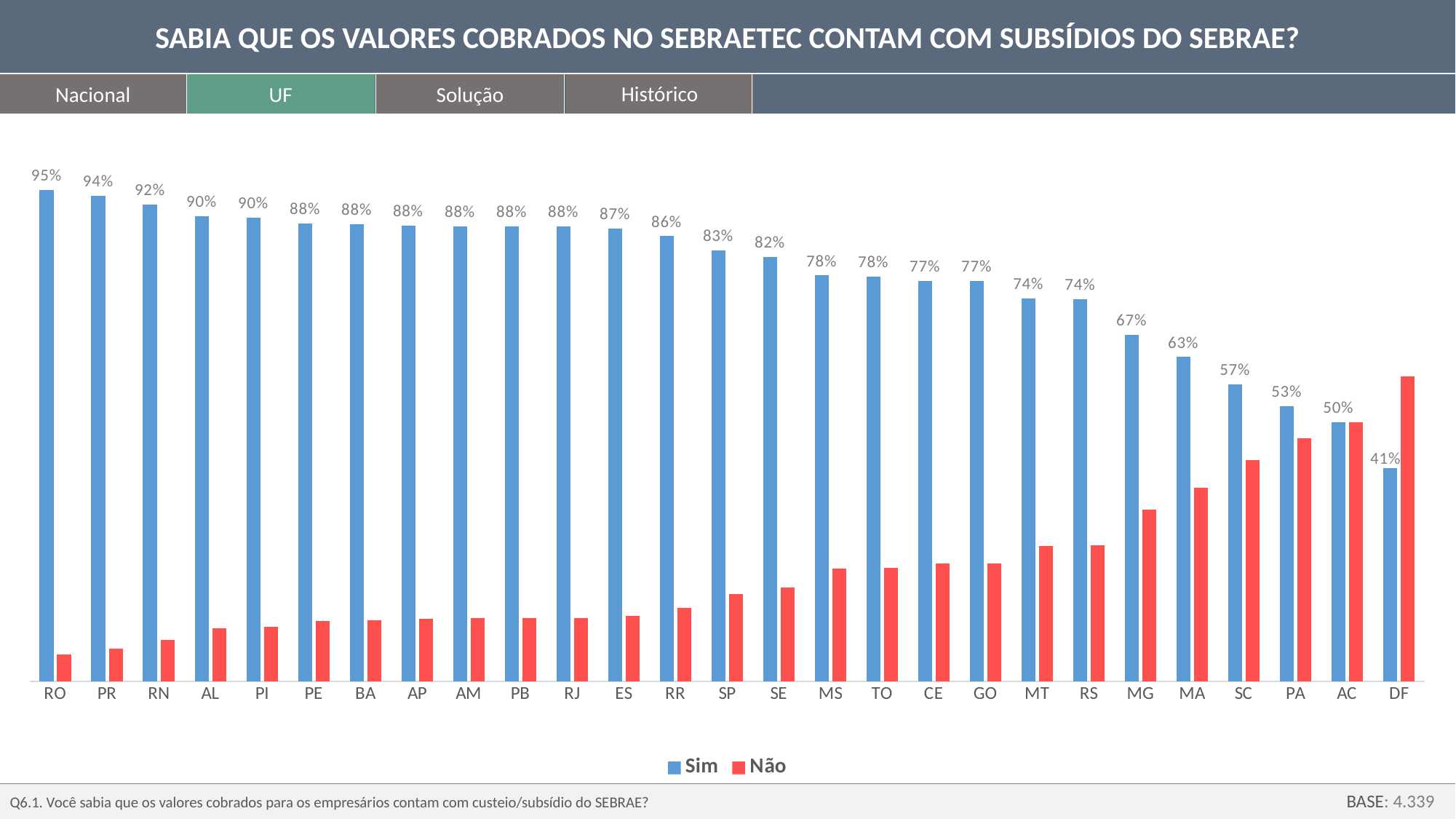
What is the 'Sim' value for MG? 67% What kind of chart is shown on the slide? Bar chart Which has the larger 'Sim' value, MA or SC? MA What is the difference between the 'Sim' values for RO and DF? 54 percentage points How many UF categories are shown along the x axis? 27 Which UF has the highest 'Sim' value? RO How many series does the legend list? 2 What are the two entries in the legend? Sim and Não Which UF has the lowest 'Sim' value? DF What is the 'Sim' value for SP? 83% Do the 'Sim' values rise or fall from left to right along the x axis? Fall What is the 'Sim' value for RO? 95%